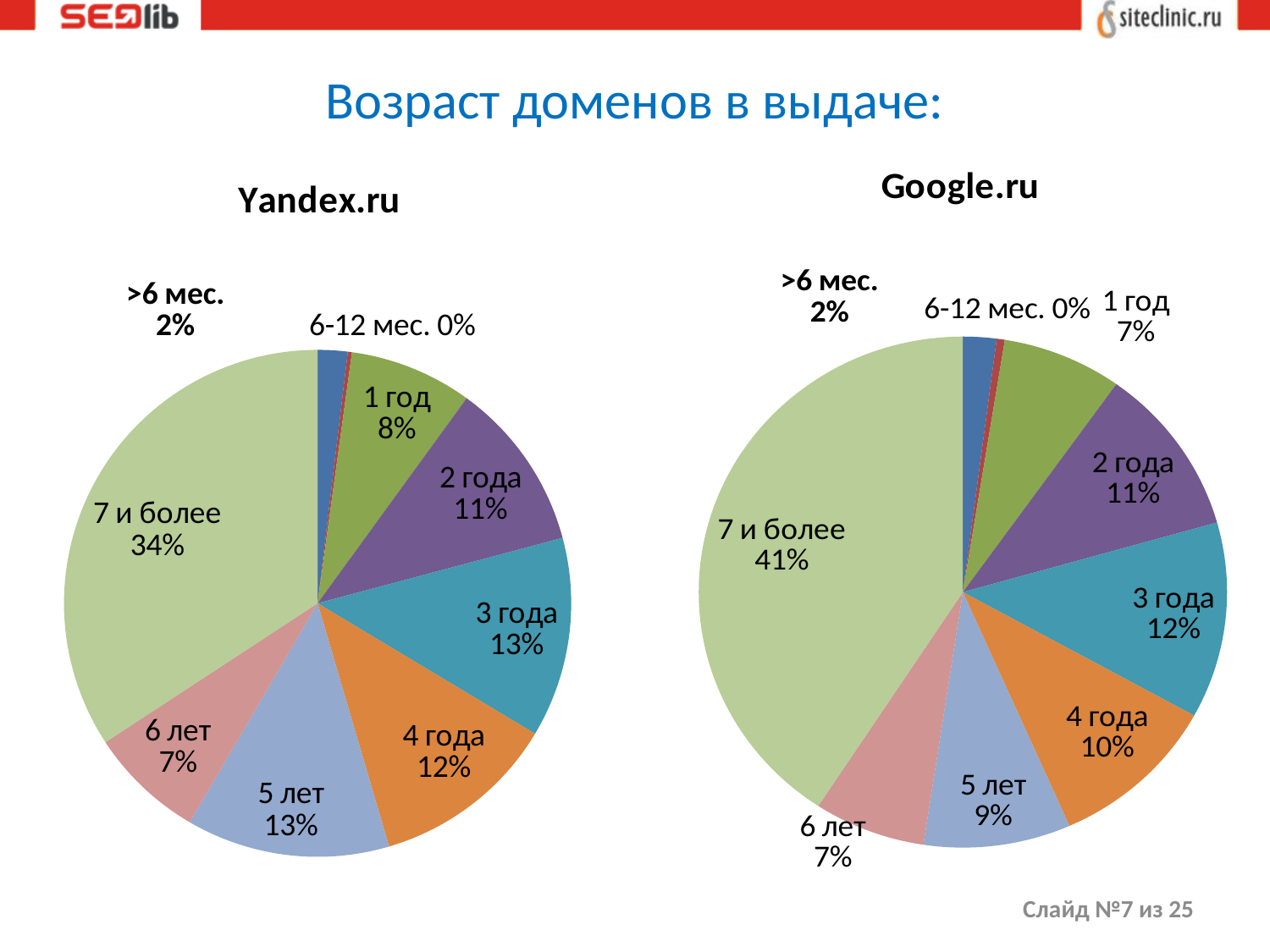
What type of chart is used for Yandex.ru? Pie chart In the Yandex.ru chart, what share do domains aged 7 и более have? 34% In the Yandex.ru chart, which is larger: the share for 3 года or the share for 4 года? 3 года In the Google.ru chart, which category has the largest share? 7 и более In the Yandex.ru chart, what is the share for 1 год? 8% What is the title of the slide? Возраст доменов в выдаче: What is the difference between the 7 и более share in Google.ru and in Yandex.ru? 7% In the Yandex.ru chart, which category has the smallest share? 6-12 мес. In the Google.ru chart, which is larger: the share for 4 года or the share for 5 лет? 4 года How many categories are shown in the Yandex.ru pie chart? 9 In the Google.ru chart, what is the share for 5 лет? 9% In the Google.ru chart, what share do domains aged 7 и более have? 41%